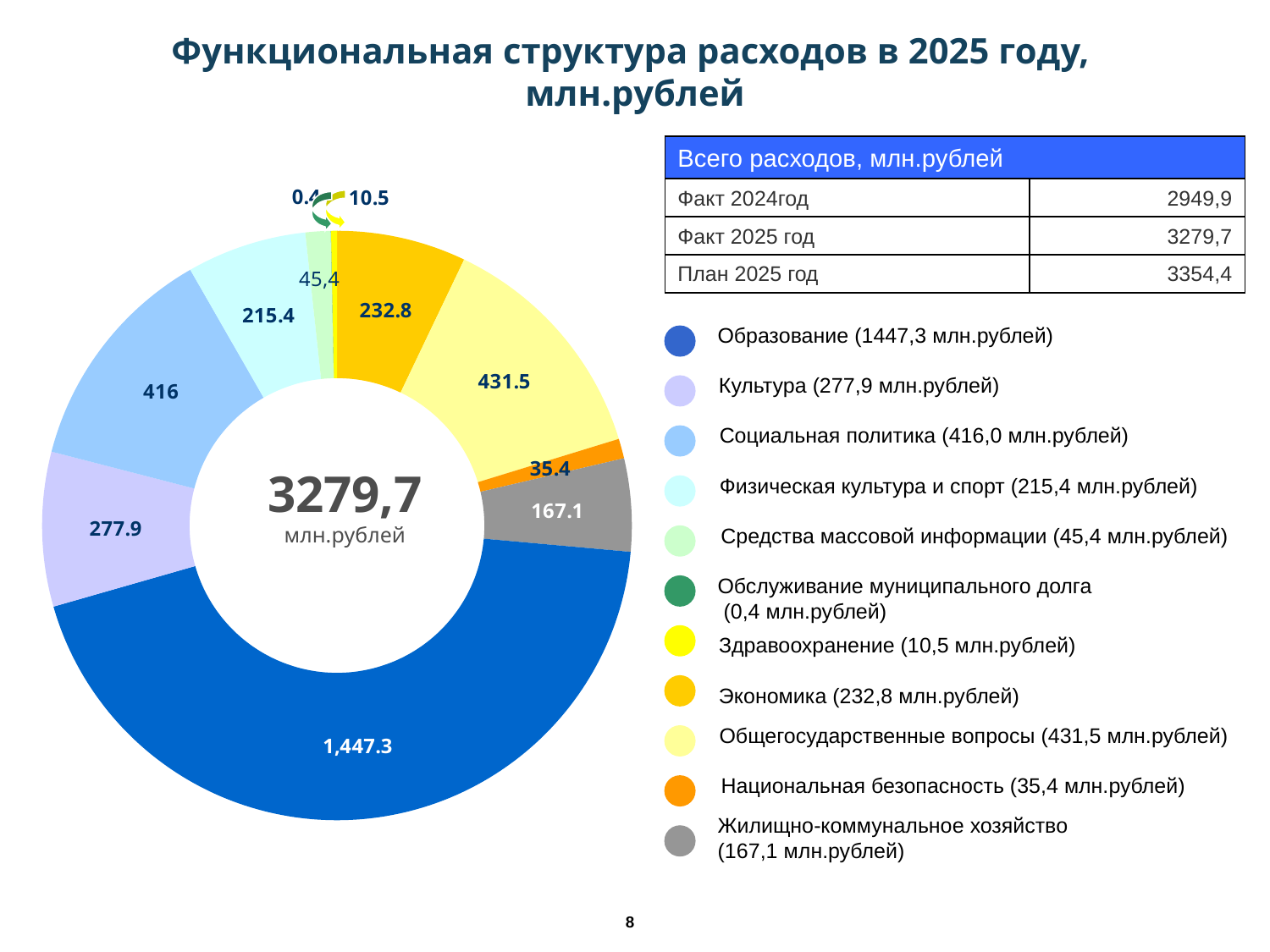
What total value is printed in the centre of the doughnut chart? 3279,7 млн.рублей What is the difference between the values for Общегосударственные вопросы and Социальная политика? 15.5 How many categories does the chart's legend list? 11 What is the value shown for Образование on the chart? 1,447.3 What kind of chart is shown on the slide? Doughnut (pie) chart Which category has the largest value on the chart? Образование Which category has the smallest value on the chart? Обслуживание муниципального долга What is the value shown for Физическая культура и спорт on the chart? 215.4 What is the value shown for Общегосударственные вопросы on the chart? 431.5 What is the difference between the values for Культура and Жилищно-коммунальное хозяйство? 110.8 What is the value shown for Жилищно-коммунальное хозяйство on the chart? 167.1 Which is larger, the value for Экономика or the value for Физическая культура и спорт? Экономика